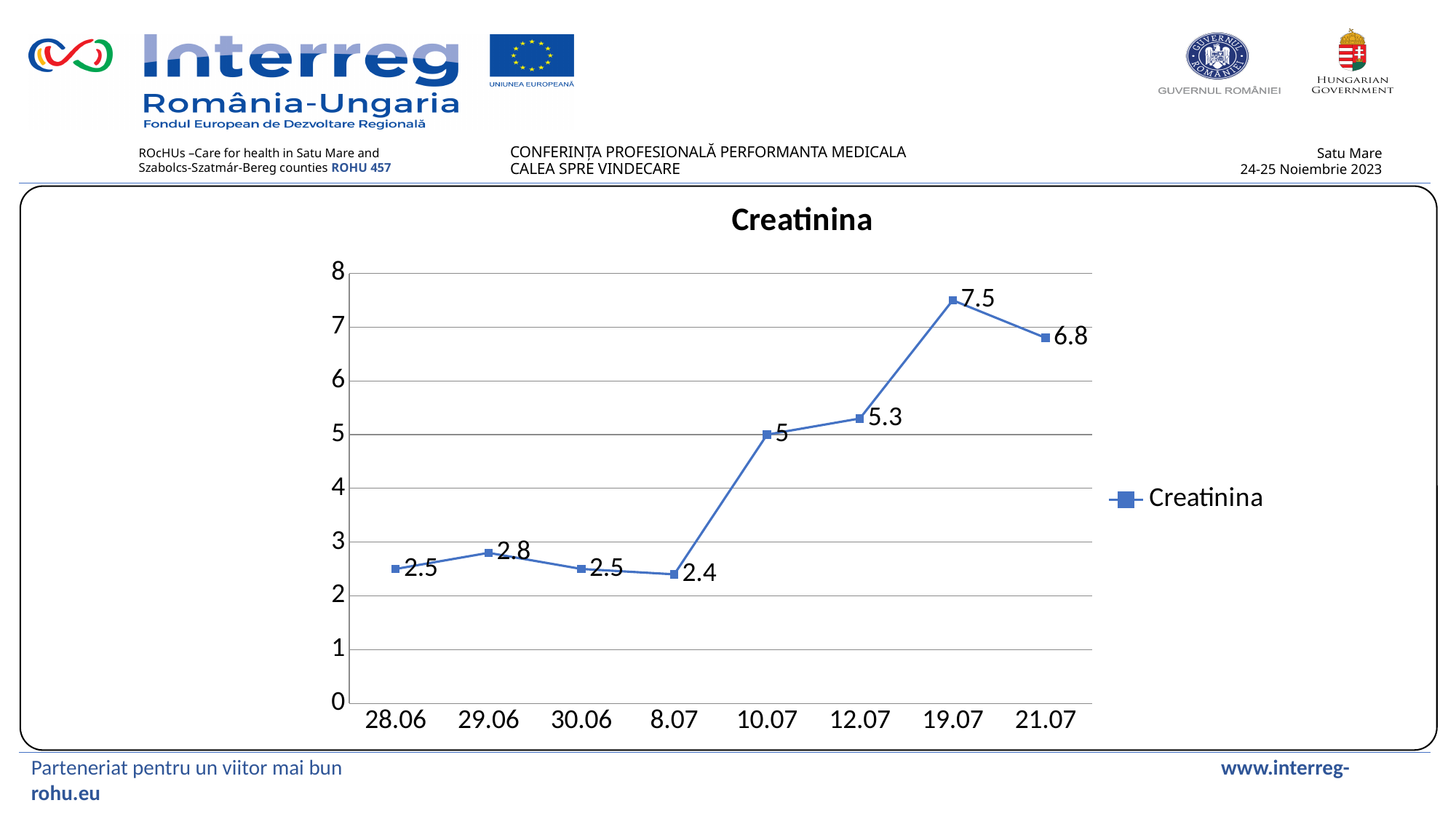
How many series does the legend list? 1 Is the Creatinina value on 21.07 greater or less than 6? greater How many dates are plotted on the x axis? 8 What is the difference between the Creatinina values on 19.07 and 21.07? 0.7 What kind of chart is shown? line chart Which date has a larger Creatinina value, 29.06 or 12.07? 12.07 What is the Creatinina value on 8.07? 2.4 On which date is the Creatinina value highest? 19.07 What is the Creatinina value on 10.07? 5 What is the title of the chart? Creatinina On which date is the Creatinina value lowest? 8.07 What is the Creatinina value on 19.07? 7.5